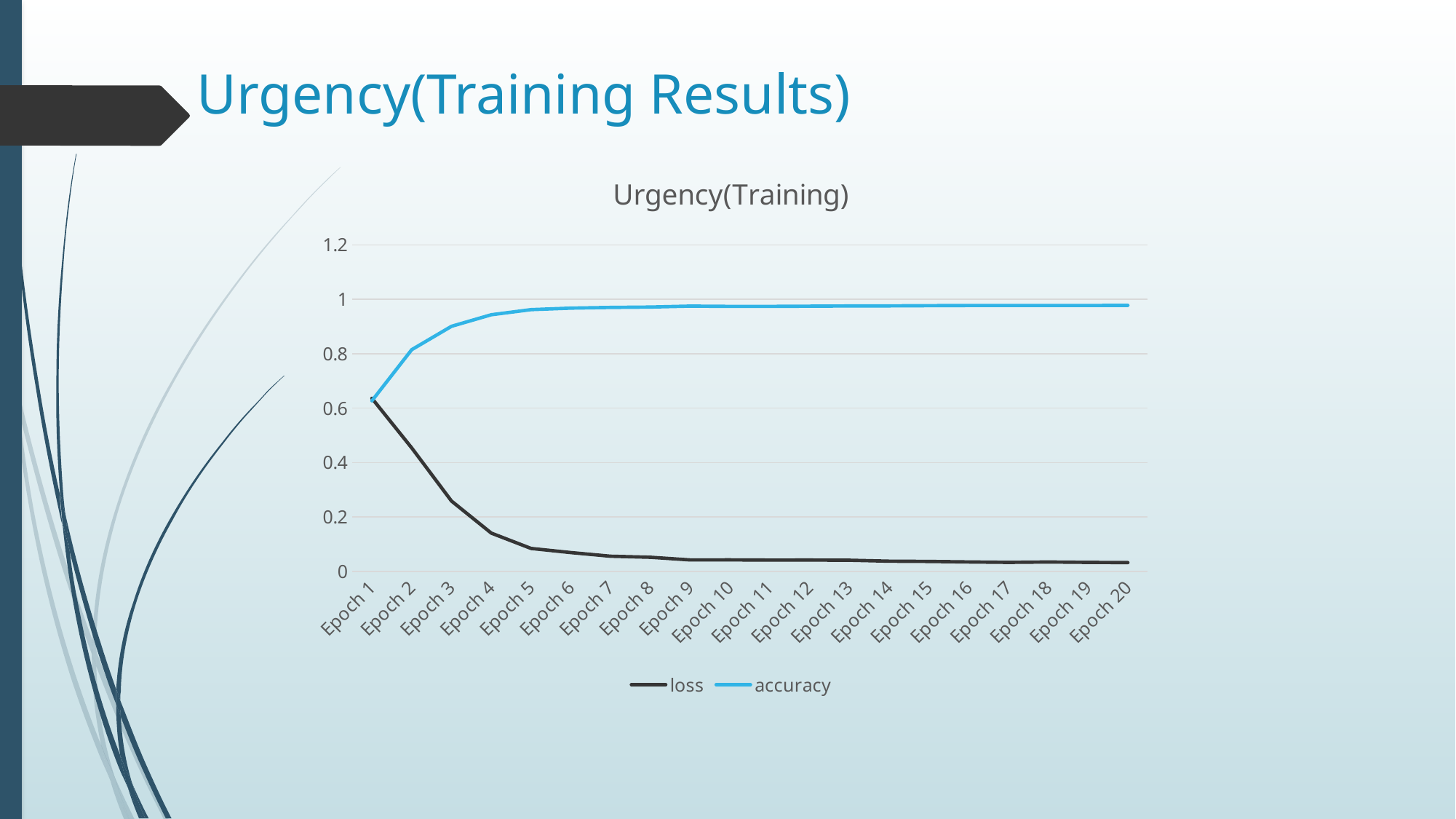
Is the loss value at Epoch 1 greater or less than 0.4? greater What kind of chart is shown on the slide? line chart At Epoch 5, which series has the larger value, loss or accuracy? accuracy Is the loss value at Epoch 10 greater or less than 0.2? less Is the accuracy value at Epoch 20 greater or less than 0.8? greater At which epoch is the loss highest? Epoch 1 How many series does the legend list? 2 How many epochs are plotted along the x axis? 20 What is the title of the chart? Urgency(Training) Does the accuracy series rise or fall across the epochs? rise Does the loss series rise or fall across the epochs? fall